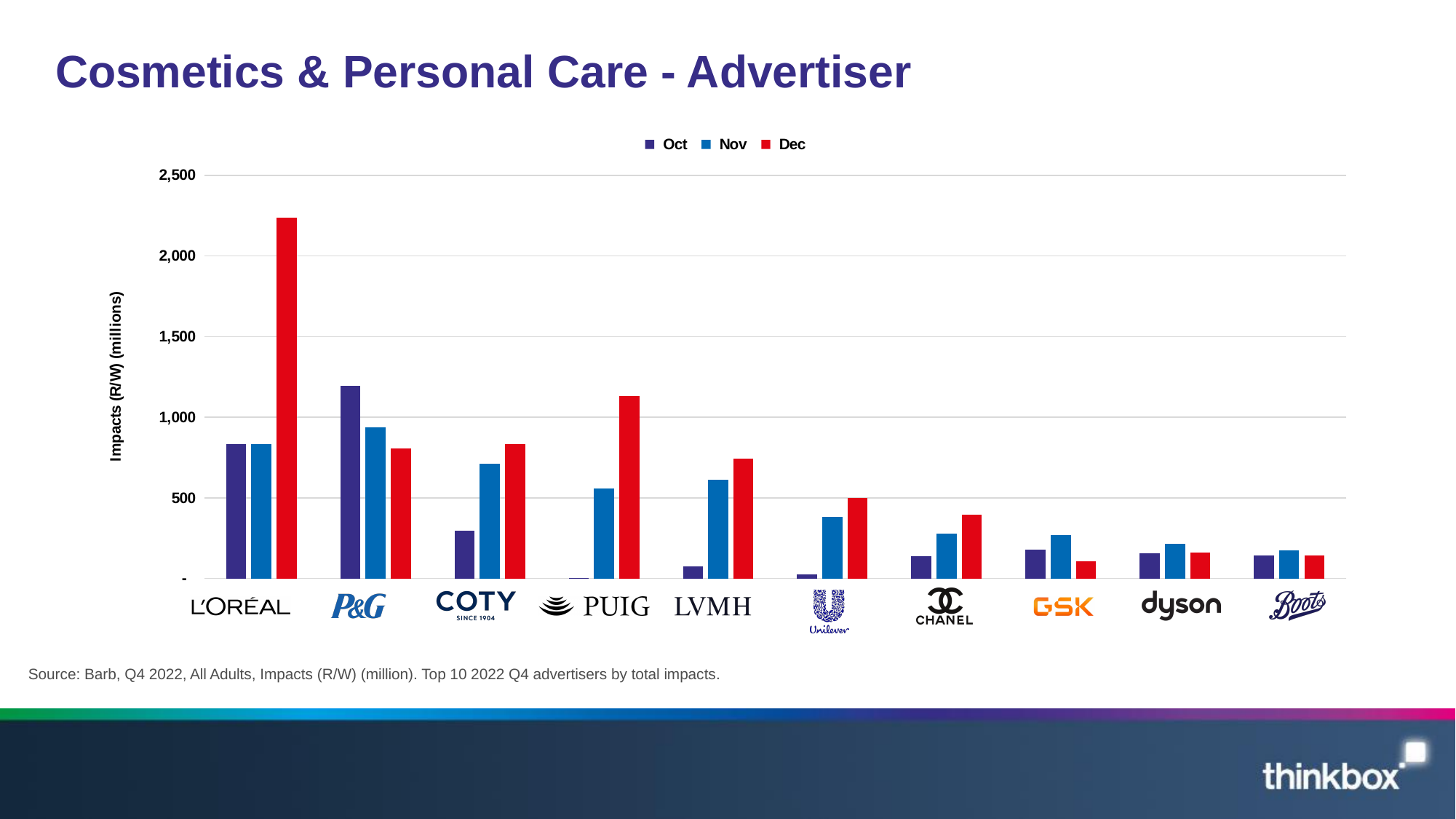
Which advertiser has the highest Oct value? P&G Is the Oct value for P&G greater or less than 1,000? greater Is the Dec value for L'Oréal greater or less than 2,000? greater How many advertisers are shown along the x axis? 10 Which advertiser has the highest Dec value? L'Oréal What kind of chart is shown on the slide? Bar chart Is the Dec value for Puig greater or less than 1,000? greater For Coty, which is larger: the Oct value or the Nov value? Nov How many series does the legend list? 3 What is the label on the vertical axis? Impacts (R/W) (millions) For P&G, which is larger: the Oct value or the Dec value? Oct